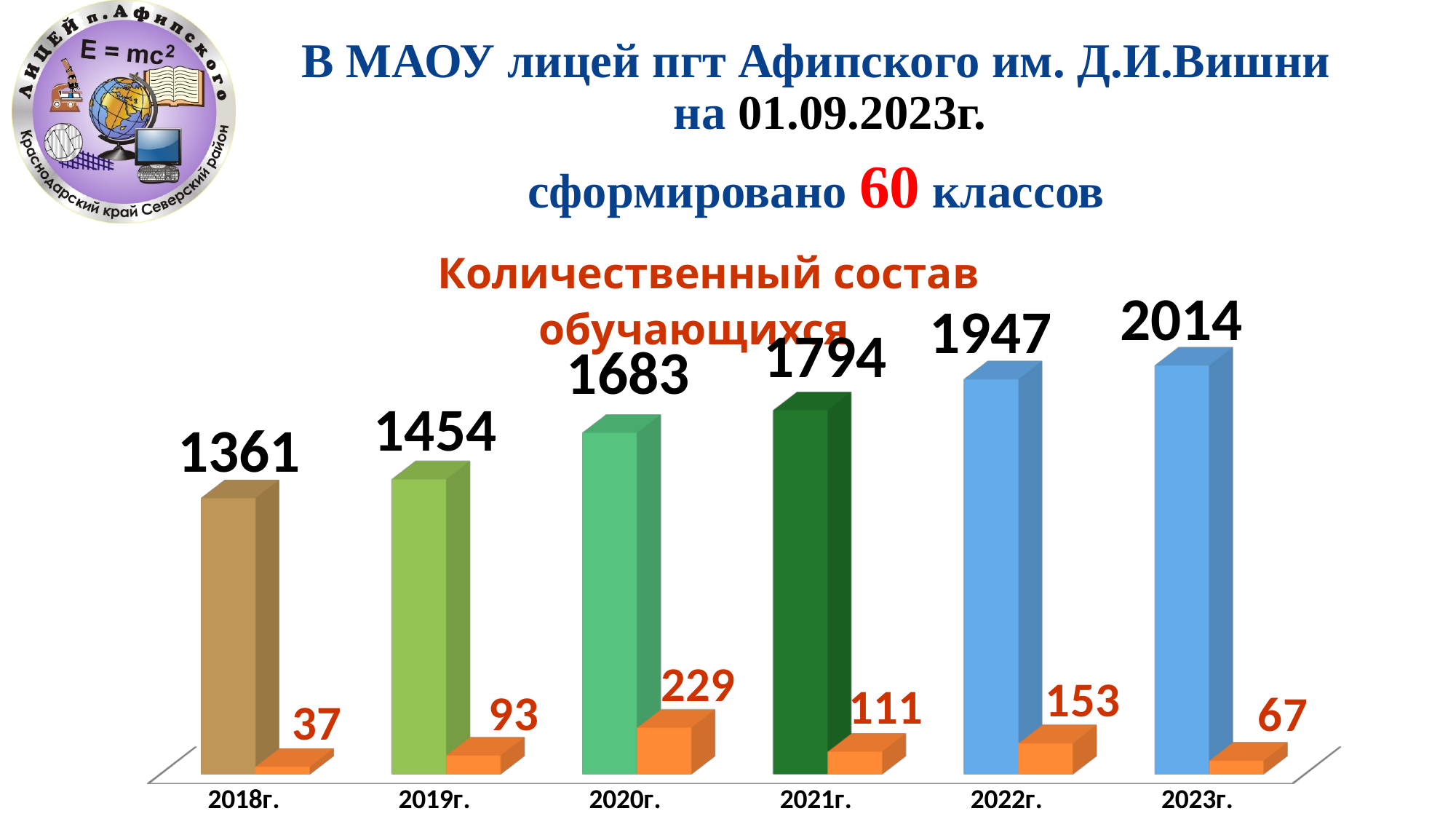
How many years are shown on the x axis of the chart? 6 What is the value of the small orange bar for 2022г.? 153 What is the value of the tall bar for 2023г.? 2014 Which year has the highest value among the small orange bars? 2020г. What is the difference between the small orange bar values for 2020г. and 2021г.? 118 Which year has the lowest value among the small orange bars? 2018г. What is the value of the tall bar for 2020г. in the chart 'Количественный состав обучающихся'? 1683 What type of chart is shown on the slide? Bar chart Which is larger: the small orange bar for 2019г. or for 2023г.? 2019г. What is the difference between the tall bar values for 2023г. and 2018г.? 653 Do the tall bar values rise or fall from 2018г. to 2023г.? Rise Which year has the highest value among the tall bars? 2023г.